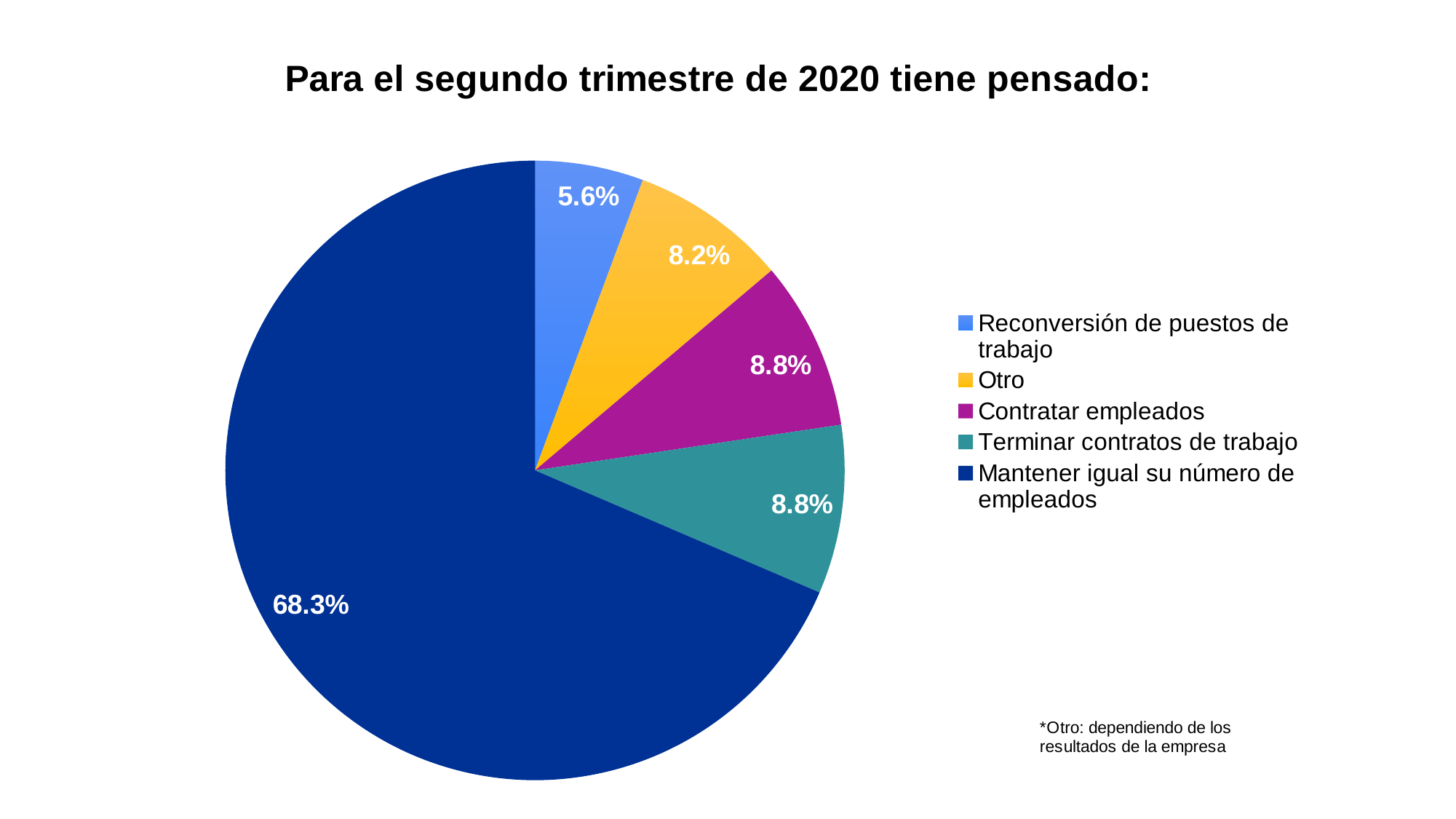
What percentage is shown for "Reconversión de puestos de trabajo"? 5.6% What is the title of the chart? Para el segundo trimestre de 2020 tiene pensado: What kind of chart is shown on the slide? pie chart Which category has the smallest slice of the pie? Reconversión de puestos de trabajo Which is larger, the share for "Otro" or the share for "Reconversión de puestos de trabajo"? Otro What is the difference between the share for "Mantener igual su número de empleados" and the share for "Otro"? 60.1% What colour is the slice for "Otro"? yellow What percentage is shown for "Otro"? 8.2% What percentage is shown for "Mantener igual su número de empleados"? 68.3% What percentage is shown for "Contratar empleados"? 8.8% Which category has the largest slice of the pie? Mantener igual su número de empleados How many categories does the legend list? 5